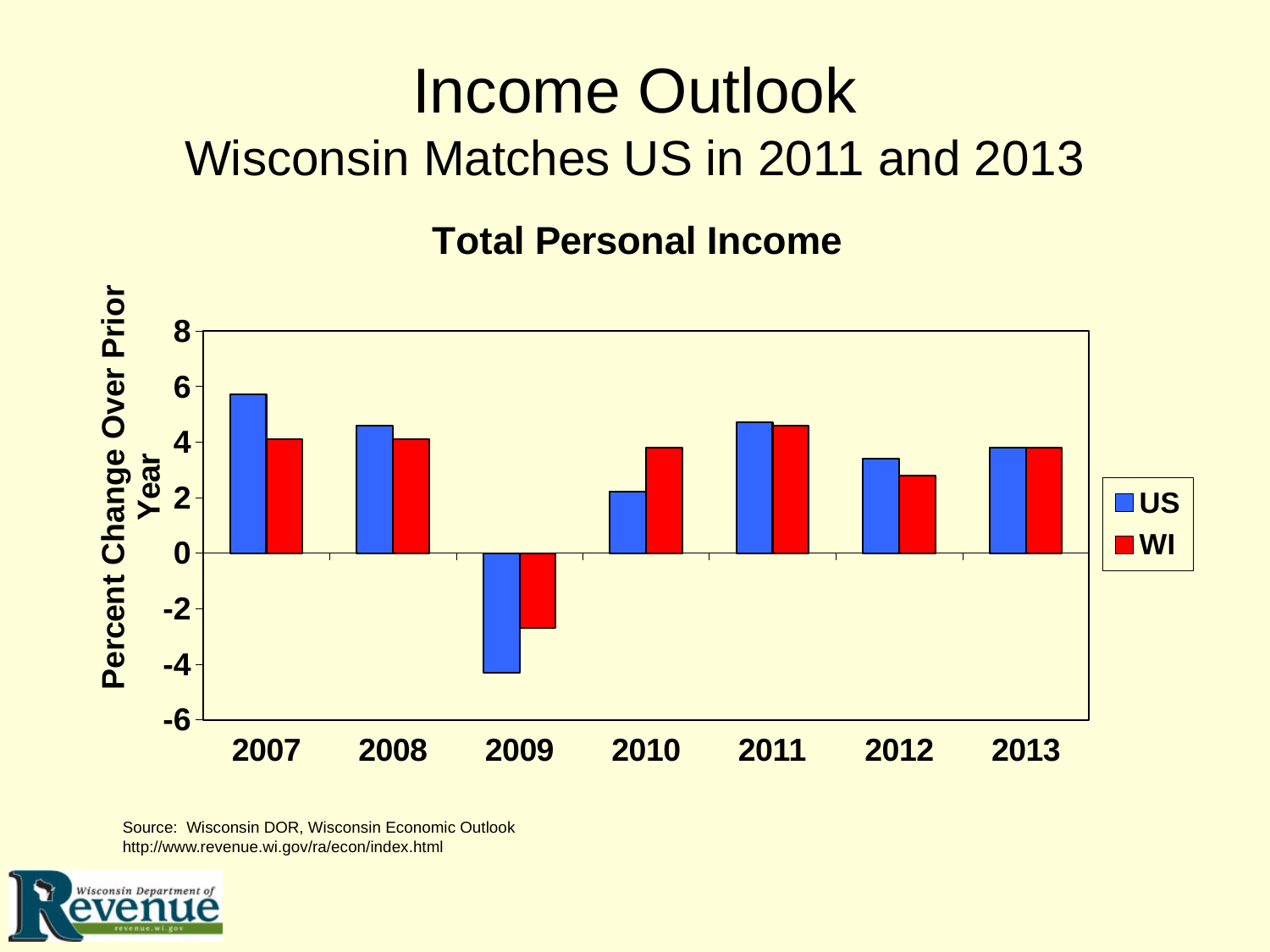
How many series does the legend list? 2 In which year is the US value lowest? 2009 In which year is the WI value lowest? 2009 Is the US value for 2007 greater or less than 4? greater Is the US value for 2010 greater or less than 4? less How many years are shown on the x axis? 7 Is the US value for 2009 greater or less than -2? less What kind of chart is shown on the slide? bar chart In 2010, which series has the larger value, US or WI? WI Do the US values rise or fall from 2007 to 2009? fall In which year is the US value highest? 2007 In 2007, which series has the larger value, US or WI? US